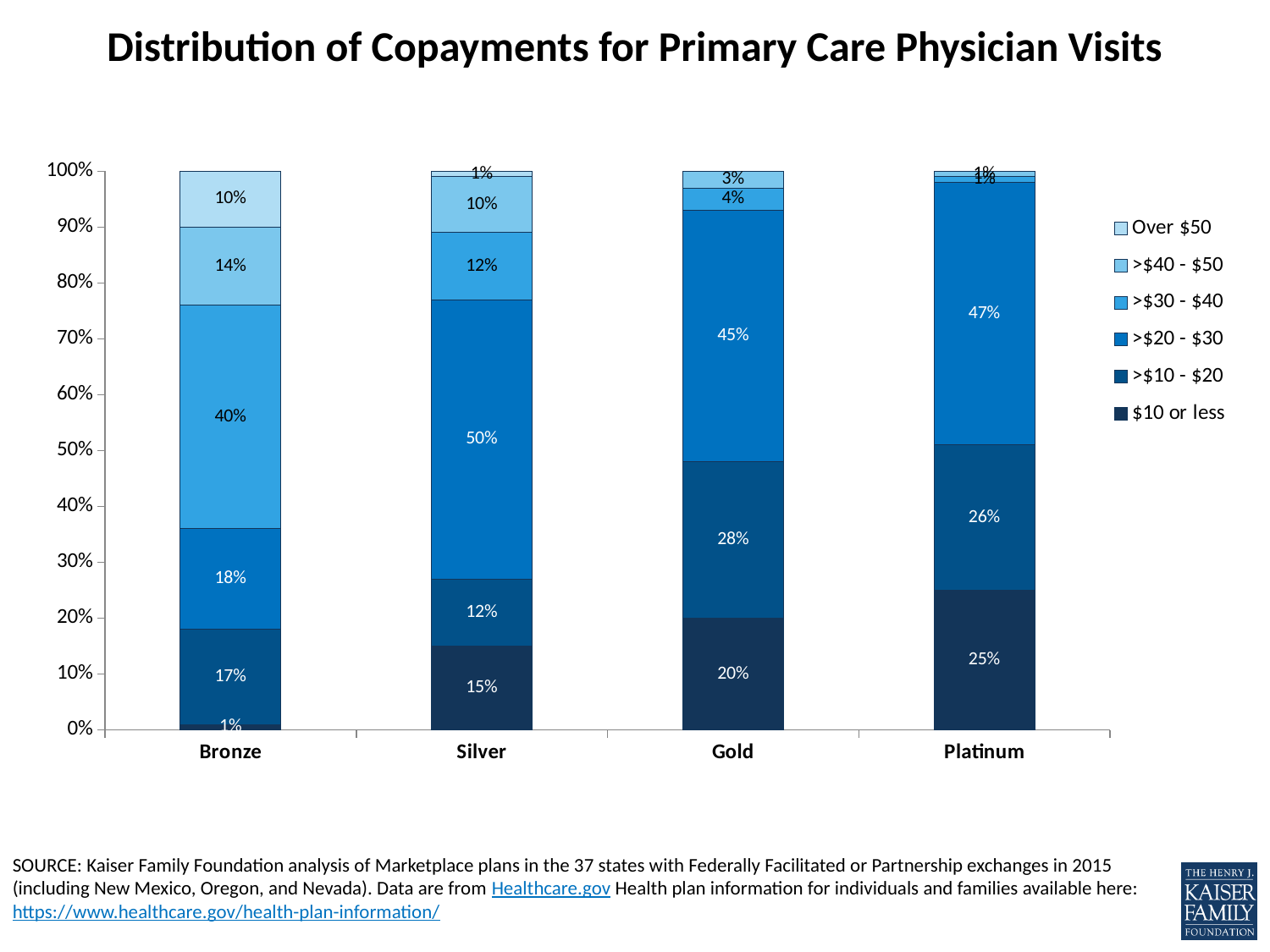
What type of chart is shown on the slide? Stacked bar chart What share of Bronze plans have a primary care copayment of >$30 - $40? 40% What share of Silver plans have a primary care copayment of >$20 - $30? 50% How many copayment ranges does the legend list? 6 Which metal level has the smallest share of plans with a copayment of $10 or less? Bronze How many metal levels are shown on the x axis? 4 What is the difference between the Platinum and Gold shares for the >$20 - $30 copayment range? 2% What share of Gold plans have a primary care copayment of >$10 - $20? 28% What share of Platinum plans have a primary care copayment of $10 or less? 25% Which is larger: the Bronze share for >$40 - $50 or the Silver share for >$40 - $50? Bronze Which metal level has the largest share of plans with a copayment of $10 or less? Platinum What is the title of the chart? Distribution of Copayments for Primary Care Physician Visits